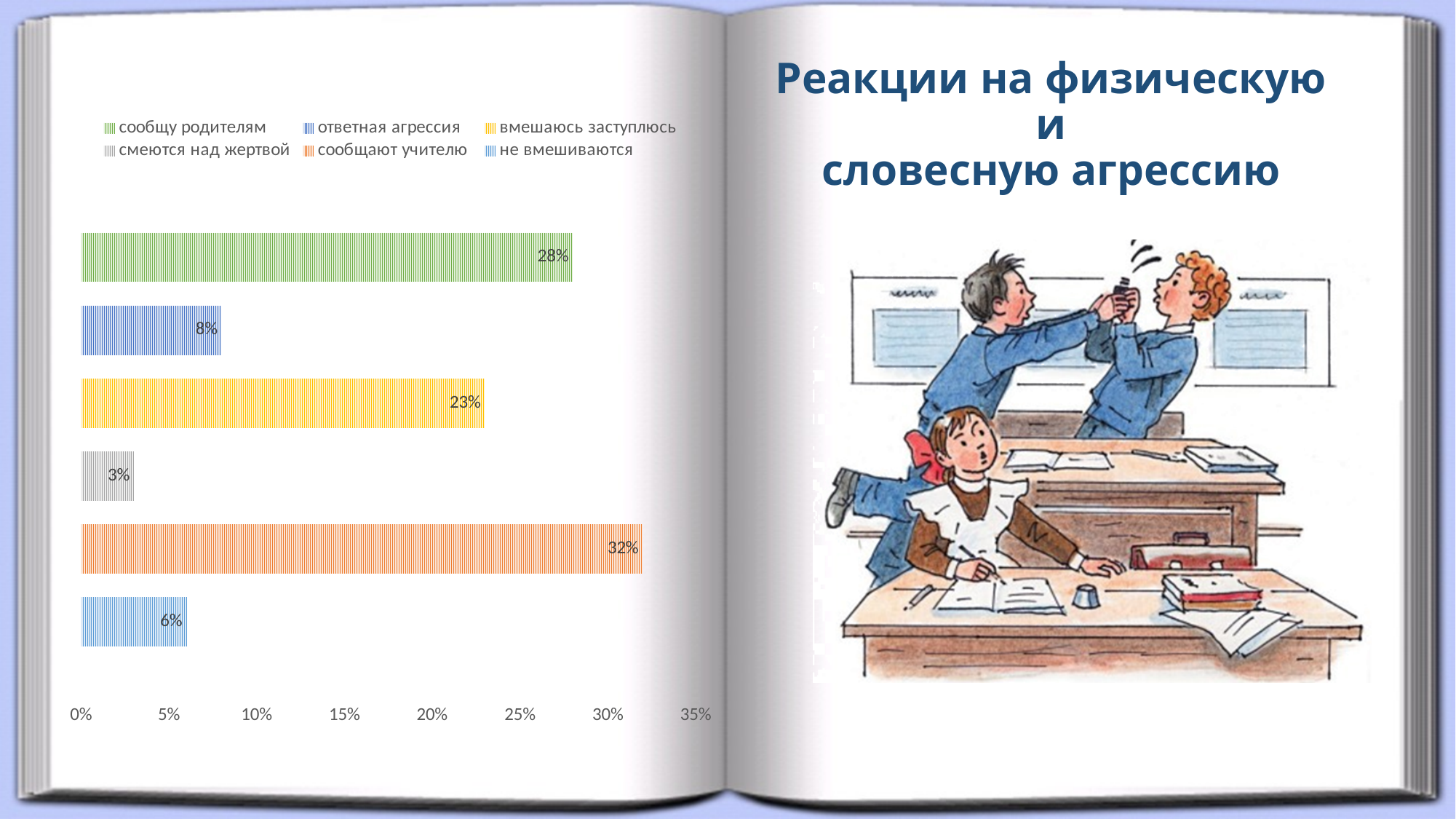
How many series does the legend list? 6 What type of chart is shown on the slide? bar chart What value is shown for "сообщают учителю"? 32% Is the value for "вмешаюсь заступлюсь" greater or less than 20%? greater Which reaction has the highest percentage? сообщают учителю How many bars are plotted in the chart? 6 What value is shown for "ответная агрессия"? 8% What percentage is shown for "вмешаюсь заступлюсь"? 23% What percentage is shown for "сообщу родителям"? 28% What is the difference between "сообщают учителю" and "сообщу родителям"? 4% Which is larger: "ответная агрессия" or "не вмешиваются"? ответная агрессия Which reaction has the lowest percentage? смеются над жертвой